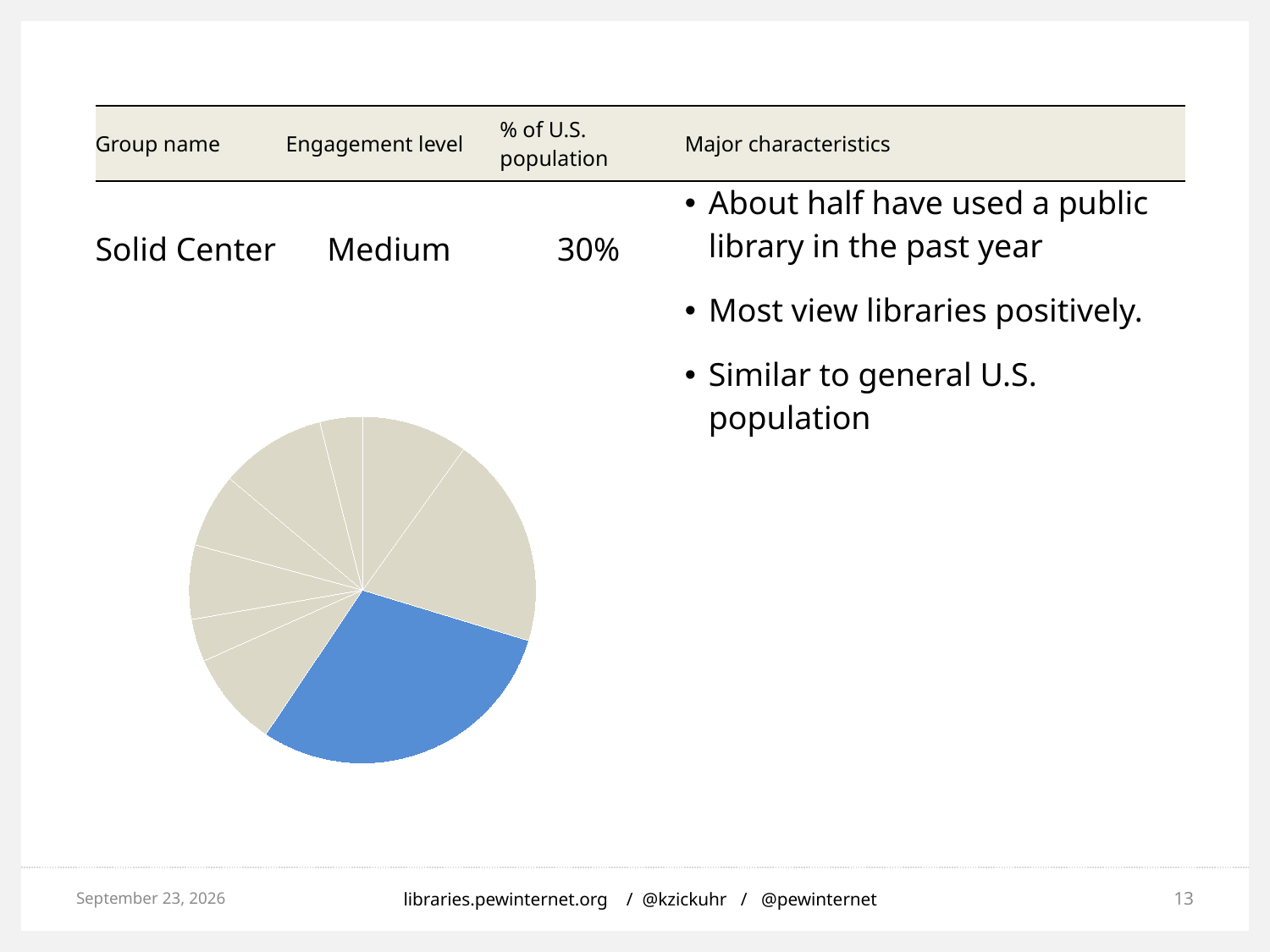
How many slices of the pie chart are coloured blue? 1 What share of the pie does the blue slice represent, according to the slide? 30% How many slices does the pie chart have? 9 Which slice of the pie chart is the largest? the blue slice Does the pie chart have a legend? No Is the blue slice of the pie chart larger or smaller than the slice immediately above it (the beige slice to its upper right)? larger What kind of chart is shown on the slide? pie chart